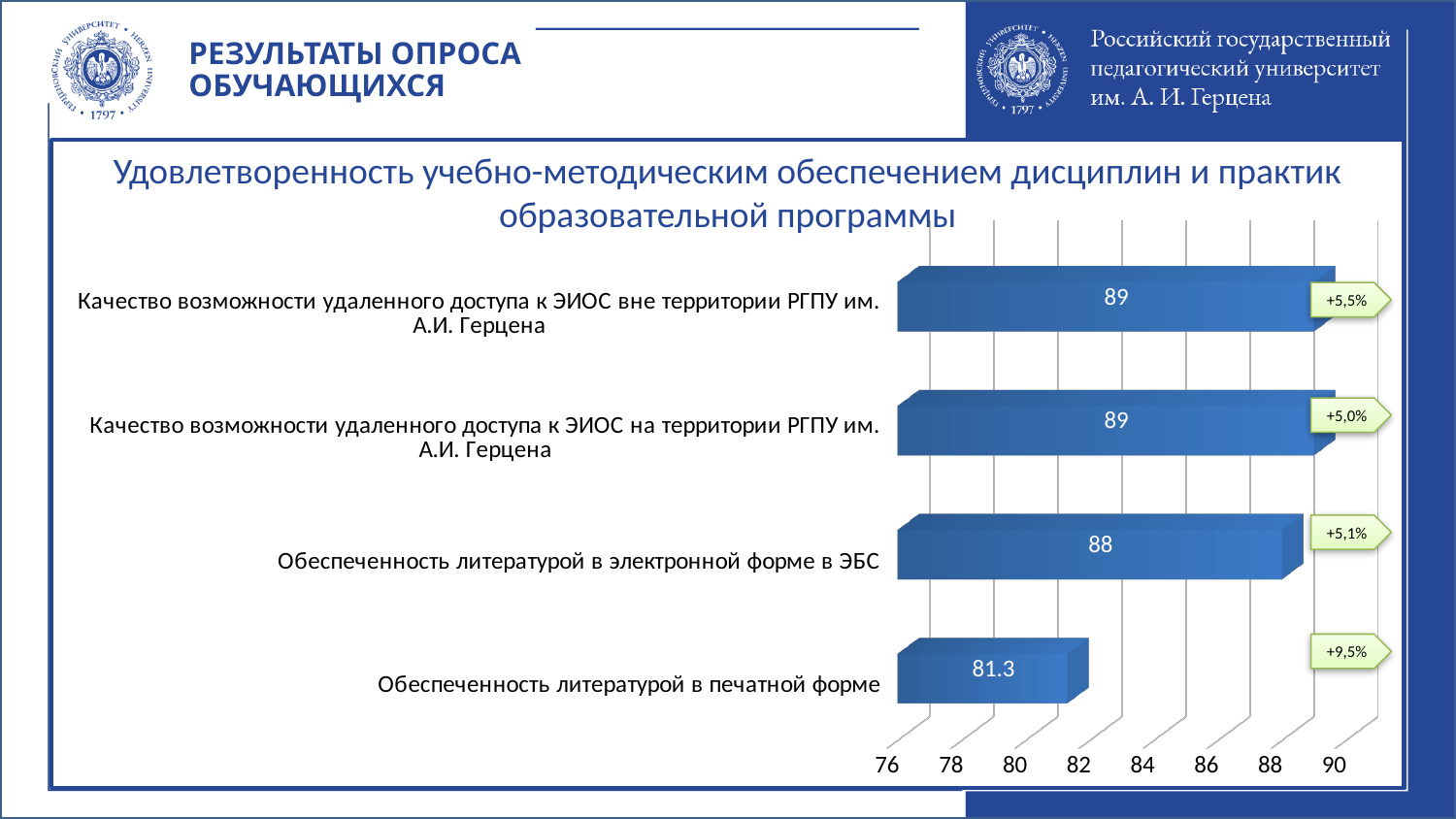
What is the value for «Обеспеченность литературой в печатной форме»? 81.3 What is the value for «Качество возможности удаленного доступа к ЭИОС вне территории РГПУ им. А.И. Герцена»? 89 What change is shown in the callout next to the bar for «Обеспеченность литературой в печатной форме»? +9,5% What is the title of the chart? Удовлетворенность учебно-методическим обеспечением дисциплин и практик образовательной программы What kind of chart is shown on the slide? Bar chart What is the difference between the value for «Обеспеченность литературой в электронной форме в ЭБС» and the value for «Обеспеченность литературой в печатной форме»? 6.7 What is the value for «Обеспеченность литературой в электронной форме в ЭБС»? 88 How many categories are shown in the chart? 4 Is the value for «Обеспеченность литературой в печатной форме» greater or less than 84? less Which category has the lowest value? Обеспеченность литературой в печатной форме What is the difference between the value for «Качество возможности удаленного доступа к ЭИОС на территории РГПУ им. А.И. Герцена» and the value for «Обеспеченность литературой в электронной форме в ЭБС»? 1 Which is larger: the value for «Обеспеченность литературой в электронной форме в ЭБС» or the value for «Обеспеченность литературой в печатной форме»? Обеспеченность литературой в электронной форме в ЭБС